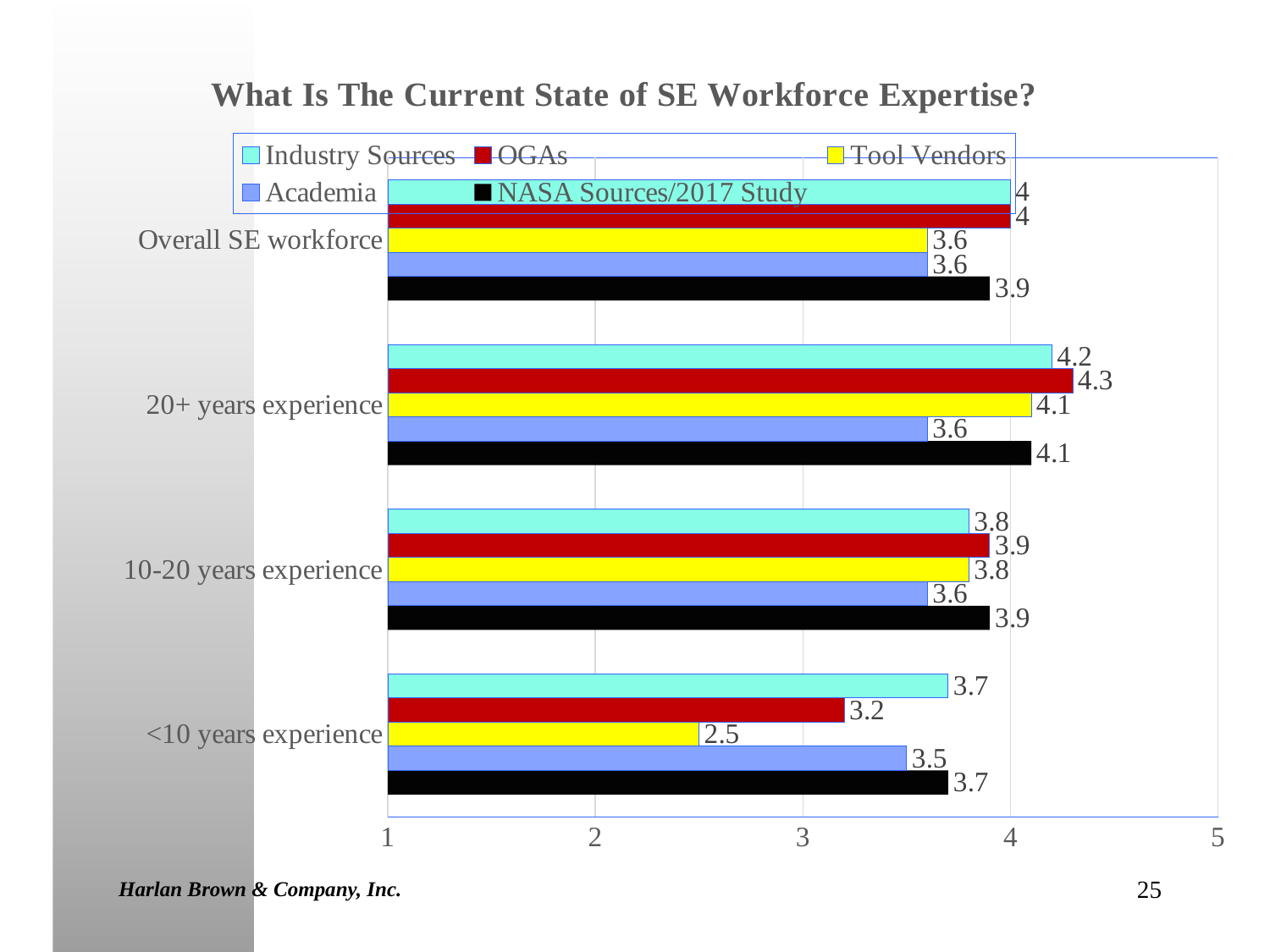
What is the title of the chart? What Is The Current State of SE Workforce Expertise? How many experience categories are shown on the chart? 4 How many series does the legend list? 5 Which is larger for 20+ years experience: the Industry Sources value or the Academia value? Industry Sources What is the OGAs value for 20+ years experience? 4.3 Which series has the highest value for 20+ years experience? OGAs Which series has the lowest value for <10 years experience? Tool Vendors What kind of chart is shown on the slide? Bar chart What is the Academia value for Overall SE workforce? 3.6 What is the NASA Sources/2017 Study value for 10-20 years experience? 3.9 What is the difference between the Industry Sources value and the OGAs value for <10 years experience? 0.5 What is the Tool Vendors value for <10 years experience? 2.5